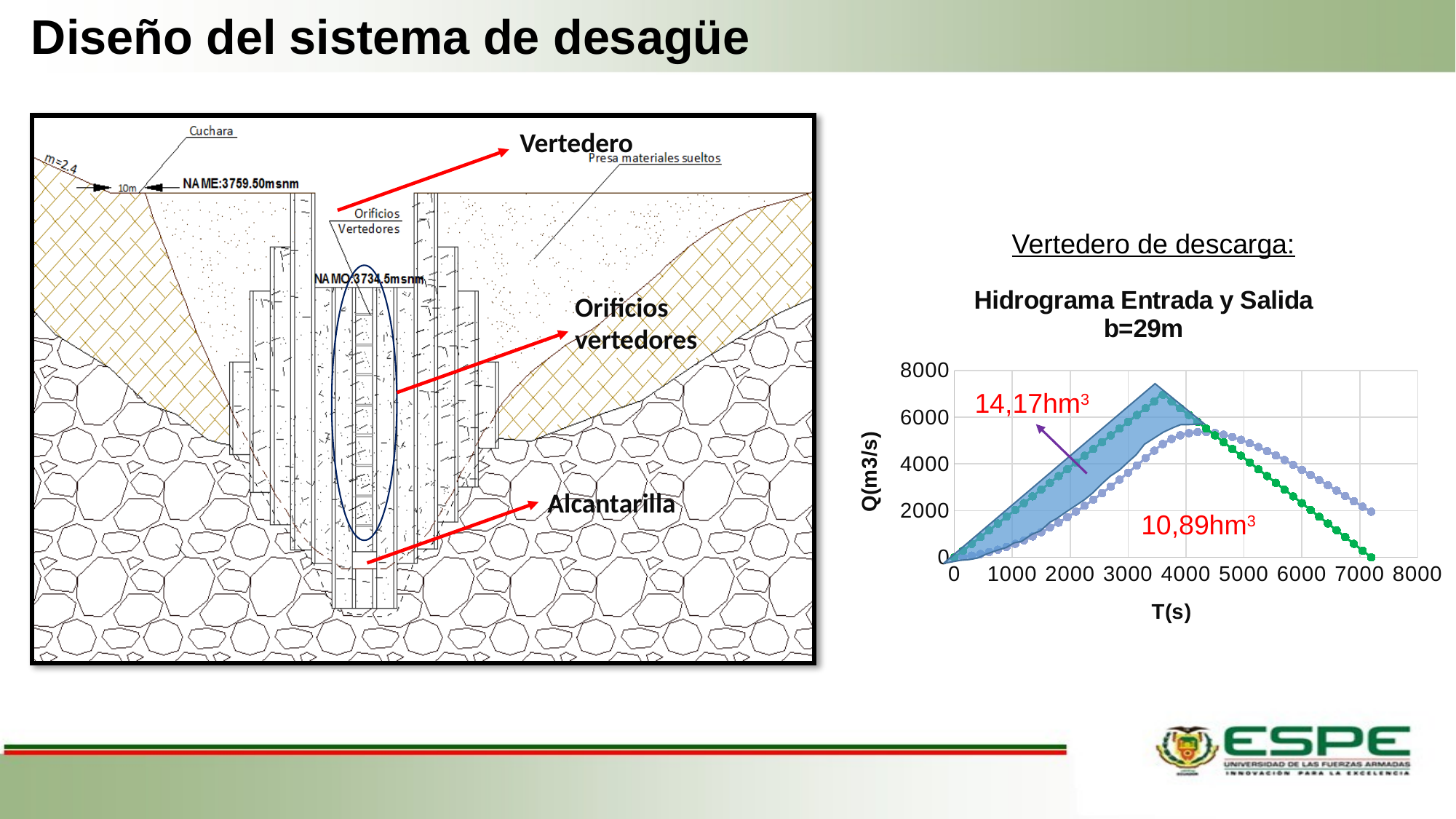
What kind of chart is the 'Hidrograma Entrada y Salida b=29m' chart? line chart In the 'Hidrograma Entrada y Salida b=29m' chart, is the peak value of the blue series greater or less than 6000? less What volume value is annotated in red near the lower right of the 'Hidrograma Entrada y Salida b=29m' chart? 10,89hm³ In the 'Hidrograma Entrada y Salida b=29m' chart, which series reaches its peak earlier along the T(s) axis, the green one or the blue one? green What volume value is annotated in red near the upper left of the shaded area in the 'Hidrograma Entrada y Salida b=29m' chart? 14,17hm³ What is the title of the chart on the right side of the slide? Hidrograma Entrada y Salida b=29m In the 'Hidrograma Entrada y Salida b=29m' chart, how does the green series behave as T(s) increases? rises then falls What is the label of the vertical axis of the 'Hidrograma Entrada y Salida b=29m' chart? Q(m3/s) In the 'Hidrograma Entrada y Salida b=29m' chart, which series reaches the higher peak, the green one or the blue one? green In the 'Hidrograma Entrada y Salida b=29m' chart, is the value of the green series at T=7000 greater or less than 2000? less In the 'Hidrograma Entrada y Salida b=29m' chart, is the peak value of the blue series greater or less than 4000? greater